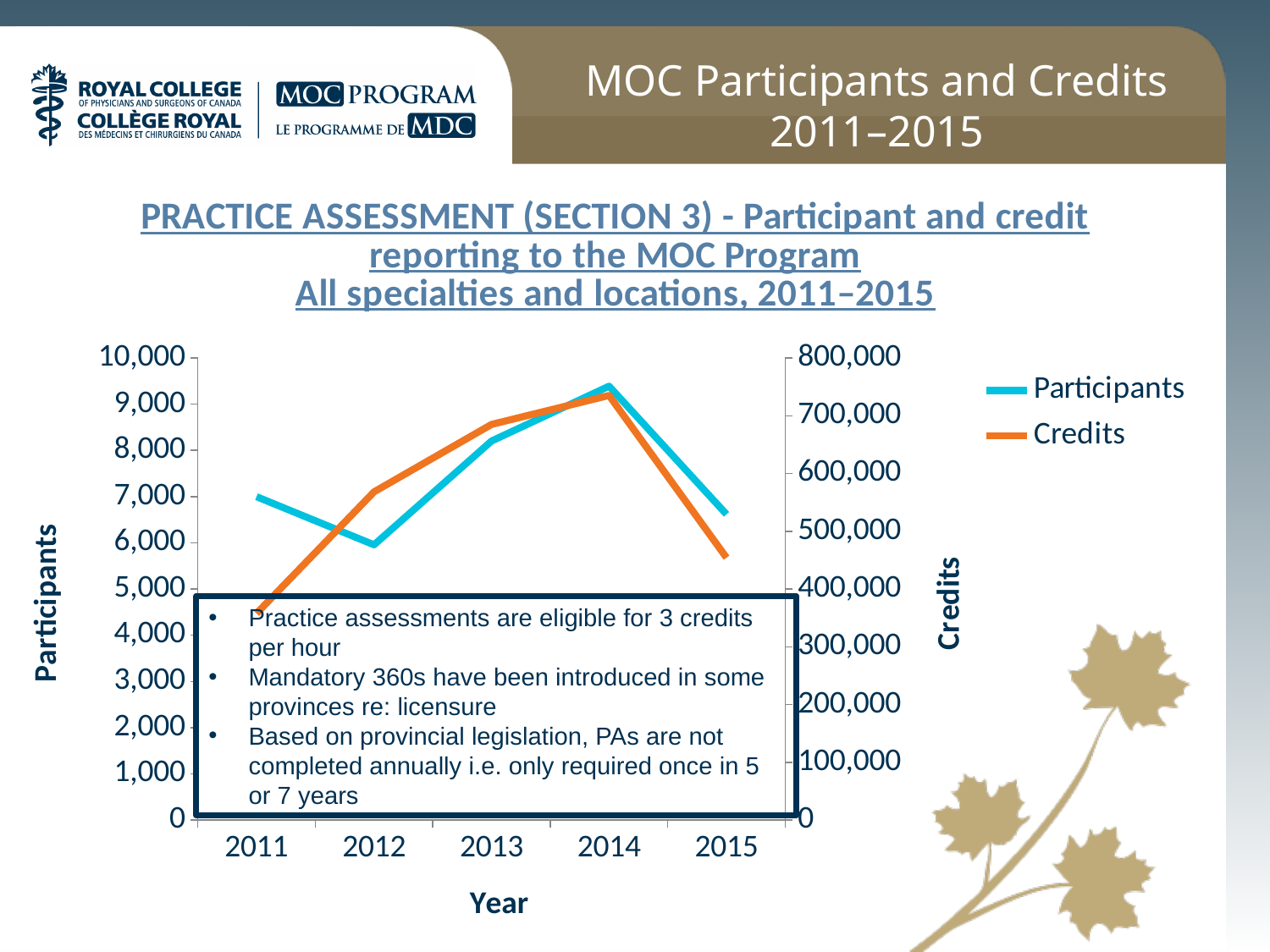
Do the Credits values rise or fall from 2011 to 2014? rise How many years are plotted along the x axis? 5 Is the Participants value for 2014 greater or less than 9,000? greater Is the Credits value for 2015 greater or less than 500,000? less In which year is the Credits series highest? 2014 How many series does the legend list? 2 Is the Participants value for 2012 greater or less than 7,000? less What is the title of the right-hand vertical axis? Credits In which year is the Participants series highest? 2014 In which year is the Participants series lowest? 2012 Which year has more Participants, 2011 or 2013? 2013 What kind of chart is shown on the slide? line chart